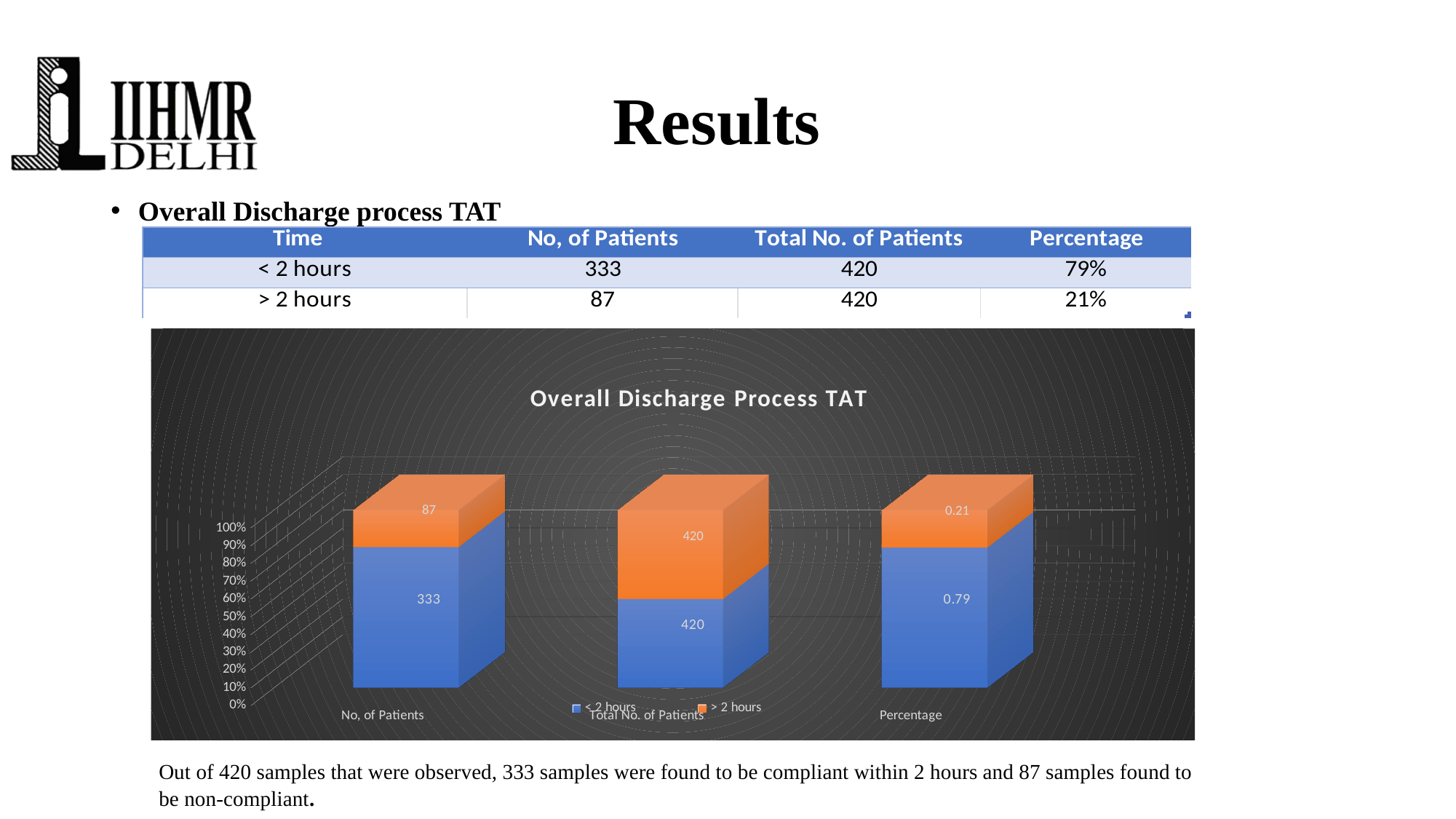
What is the difference between the < 2 hours and > 2 hours values for the No, of Patients category? 246 What is the value of the < 2 hours series for the No, of Patients category? 333 For the No, of Patients category, which series has the larger value, < 2 hours or > 2 hours? < 2 hours What is the title of the chart? Overall Discharge Process TAT How many series does the chart legend list? 2 What type of chart is shown on the slide? stacked bar chart What is the value of the < 2 hours series for the Percentage category? 0.79 What is the value of the > 2 hours series for the No, of Patients category? 87 What is the value of the > 2 hours series for the Total No. of Patients category? 420 What is the value of the > 2 hours series for the Percentage category? 0.21 How many categories are shown on the x axis of the chart? 3 Which colour represents the > 2 hours series in the chart? orange